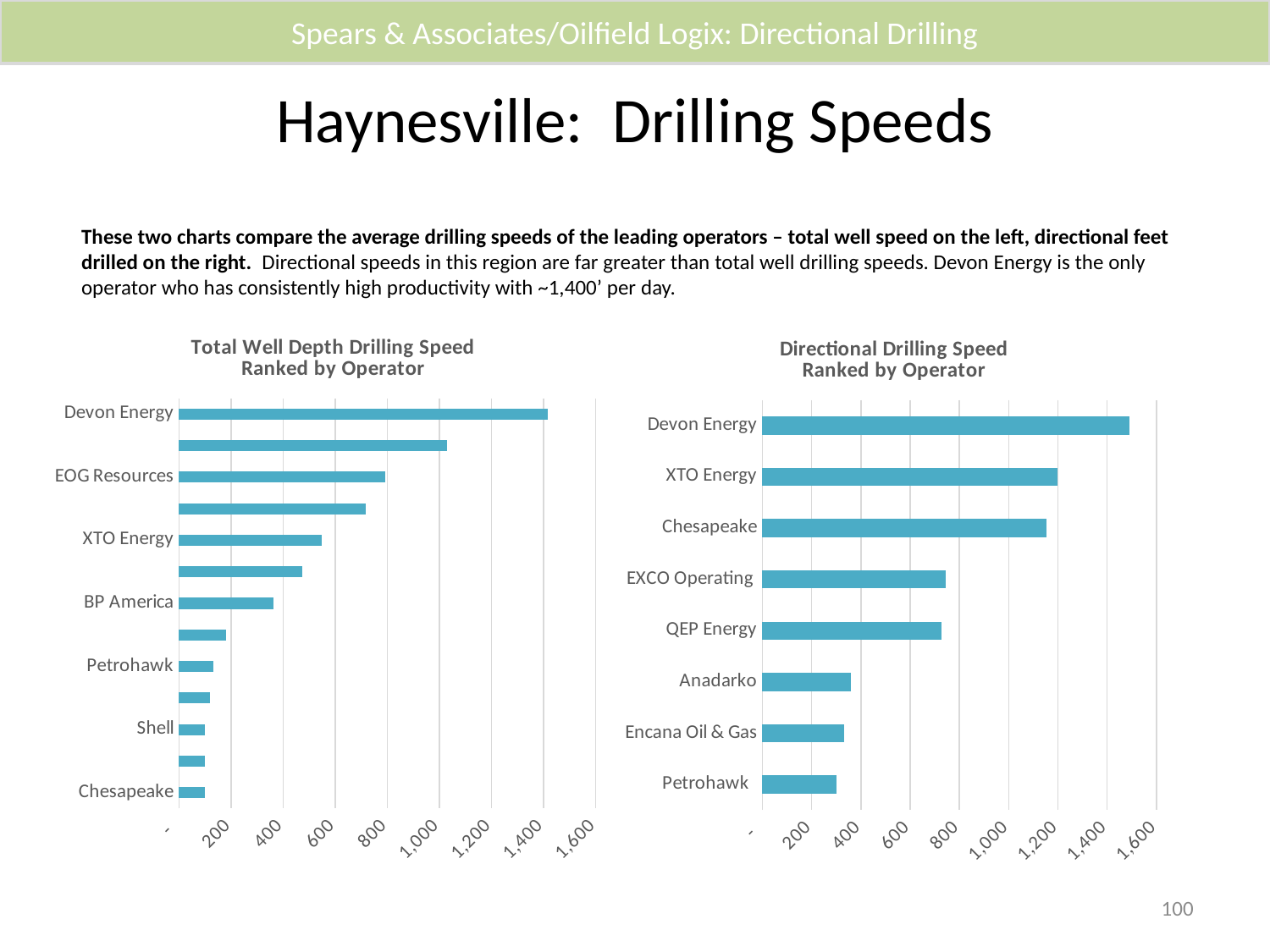
In the 'Directional Drilling Speed Ranked by Operator' chart, is the value for Anadarko greater or less than 400? less In the 'Directional Drilling Speed Ranked by Operator' chart, which operator has the lowest value? Petrohawk How many operators are shown in the 'Directional Drilling Speed Ranked by Operator' chart? 8 In the 'Total Well Depth Drilling Speed Ranked by Operator' chart, which operator has the highest value? Devon Energy In the 'Directional Drilling Speed Ranked by Operator' chart, is the value for Devon Energy greater or less than 1,400? greater In the 'Directional Drilling Speed Ranked by Operator' chart, which is larger, Chesapeake or EXCO Operating? Chesapeake In the 'Total Well Depth Drilling Speed Ranked by Operator' chart, is the value for Petrohawk greater or less than 200? less In the 'Directional Drilling Speed Ranked by Operator' chart, which operator has the highest value? Devon Energy What kind of chart is the 'Directional Drilling Speed Ranked by Operator' chart? bar chart In the 'Total Well Depth Drilling Speed Ranked by Operator' chart, which is larger, XTO Energy or BP America? XTO Energy